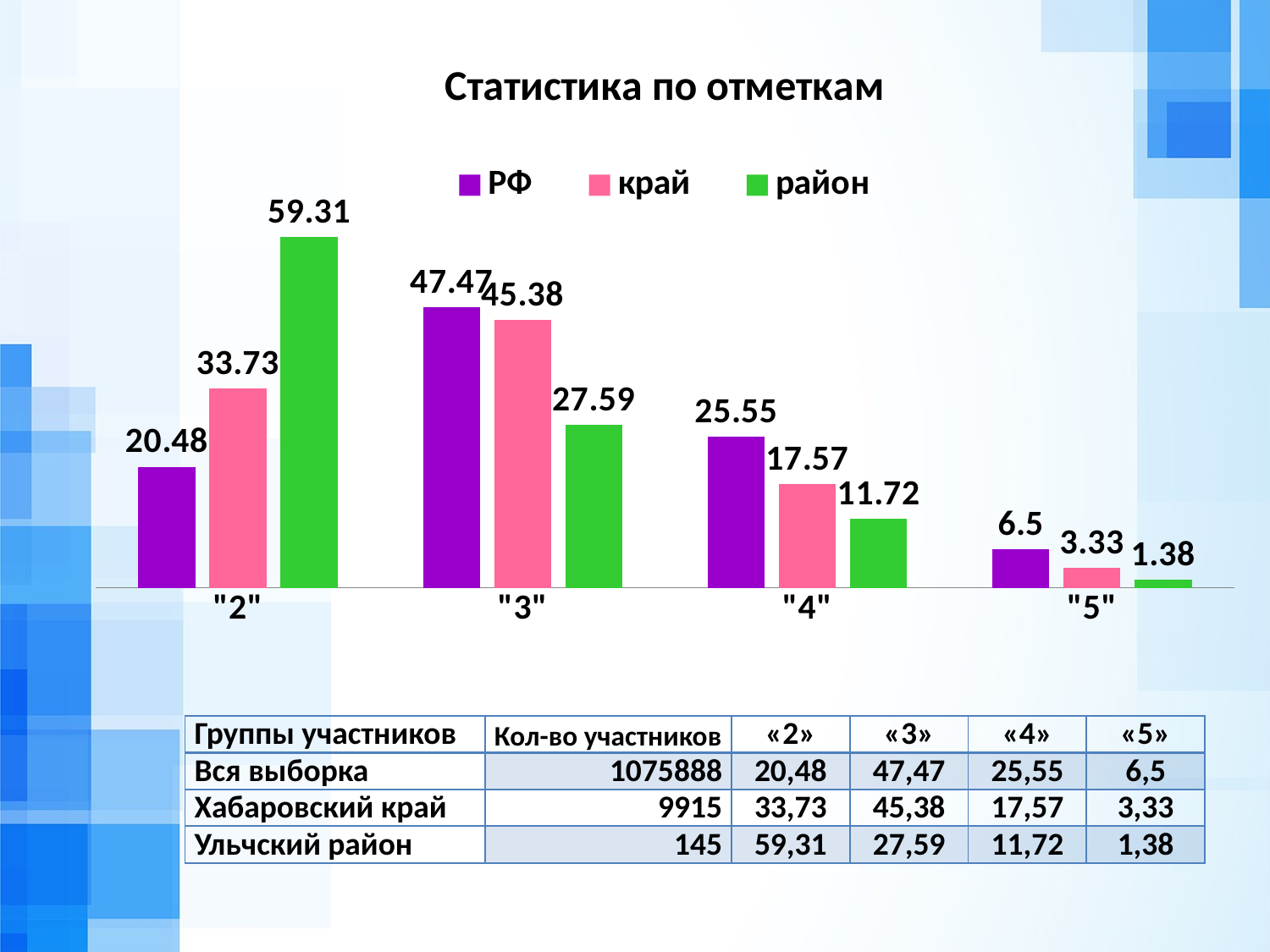
How many series does the legend list? 3 What is the difference between the район and РФ values at mark "2"? 38.83 What is the value for район at mark "5"? 1.38 What kind of chart is shown on the slide? bar chart Which mark has the lowest value for the РФ series? "5" What is the value for район at mark "3"? 27.59 What is the value for РФ at mark "2"? 20.48 Which mark has the highest value for the район series? "2" What is the value for край at mark "4"? 17.57 What is the title of the chart? Статистика по отметкам Which is larger at mark "3": РФ or край? РФ How many marks (categories) are shown on the x axis? 4